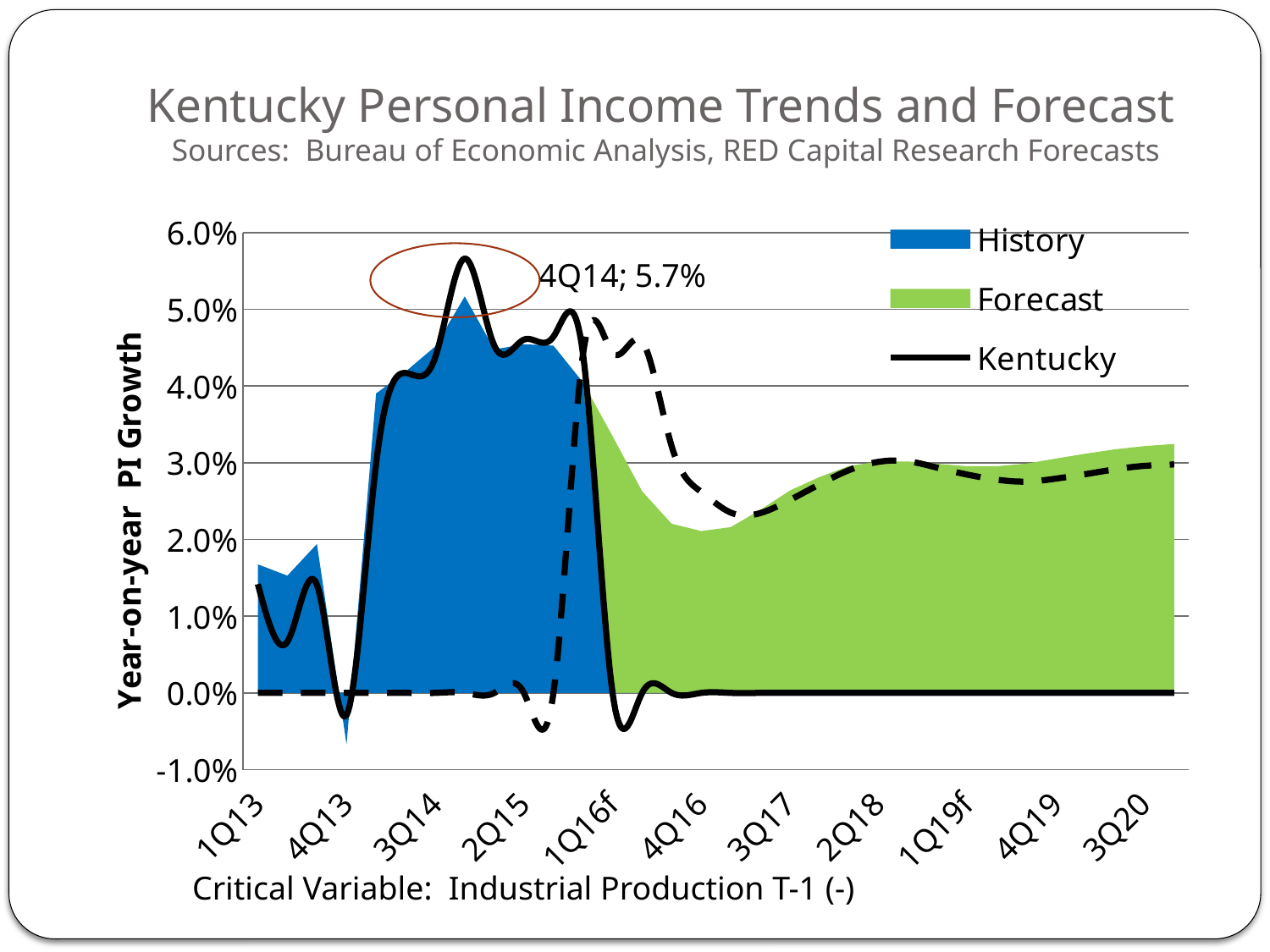
How many quarter labels are shown on the x axis? 11 Which legend entry is shown in green? Forecast What is the title of the chart on the slide? Kentucky Personal Income Trends and Forecast Is the Forecast value at 3Q20 greater or less than 2.0%? greater Does the Forecast area rise or fall between 1Q16f and 4Q16? fall Is the Kentucky line's value at 4Q14 greater or less than 5.0%? greater What value is printed at the labeled peak of the Kentucky line? 5.7% In which quarter does the labeled peak of 5.7% occur? 4Q14 What is the highest value shown on the y axis? 6.0% Is the Forecast value at 4Q16 greater or less than 3.0%? less What kind of chart is shown on the slide? area and line chart How many series does the chart's legend list? 3